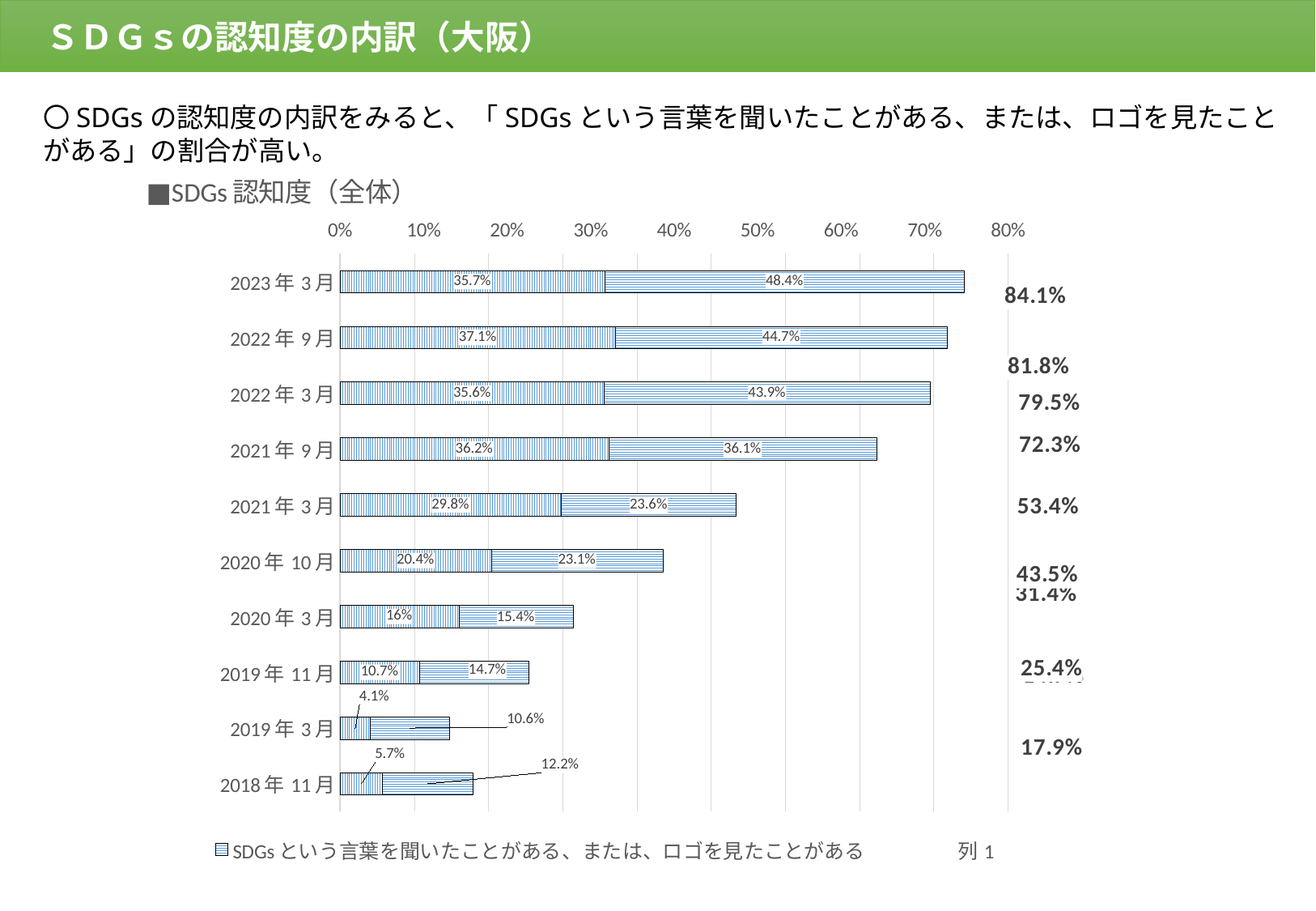
Which is larger: the first segment for 2021年3月 or the first segment for 2020年10月? 2021年3月 Is the total length of the bar for 2020年3月 greater or less than 40%? less What is the difference between the 列1 values for 2023年3月 and 2022年9月? 2.3% Which time period has the highest value for the 列1 segment? 2023年3月 How many time periods (categories) are plotted in the chart? 10 What is the total of the stacked bar for 2021年9月? 72.3% Which time period has the lowest value for the first segment (SDGsという言葉を聞いたことがある、または、ロゴを見たことがある)? 2019年3月 What type of chart is shown on the slide? stacked bar chart What is the value of the 列1 segment for 2018年11月? 17.9% How many series does the chart legend list? 2 What is the value of the 列1 segment for 2022年9月? 81.8%